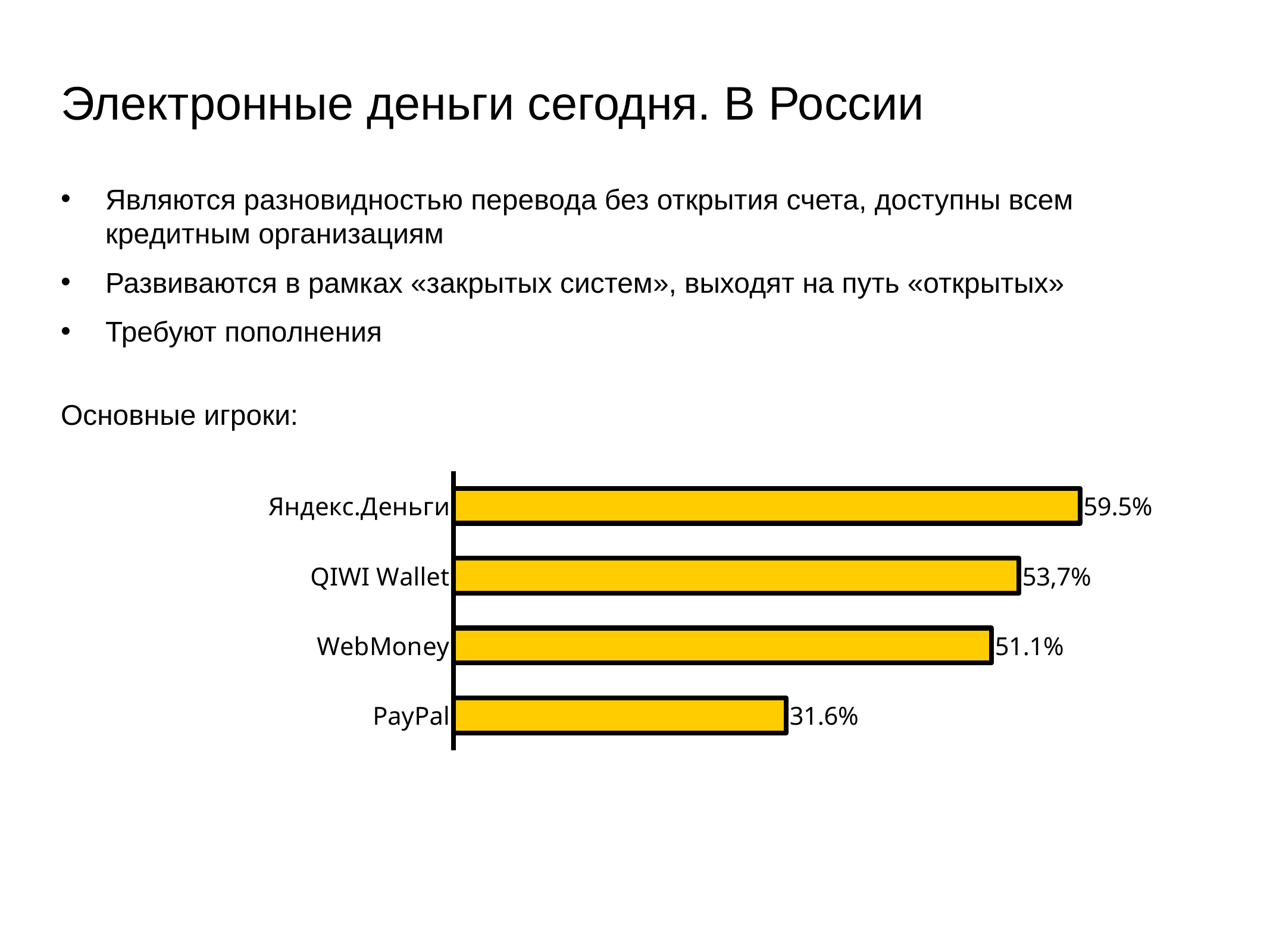
What kind of chart is shown on the slide? bar chart What is the value for QIWI Wallet? 53,7% What is the value for PayPal? 31.6% What is the value for Яндекс.Деньги? 59.5% What is the difference between the values for QIWI Wallet and WebMoney? 2.6% What colour are the bars in the chart? yellow What is the value for WebMoney? 51.1% Which category has the lowest value? PayPal What is the difference between the values for Яндекс.Деньги and PayPal? 27.9% How many categories are shown in the chart? 4 Which is larger, the value for WebMoney or the value for PayPal? WebMoney Which category has the highest value? Яндекс.Деньги